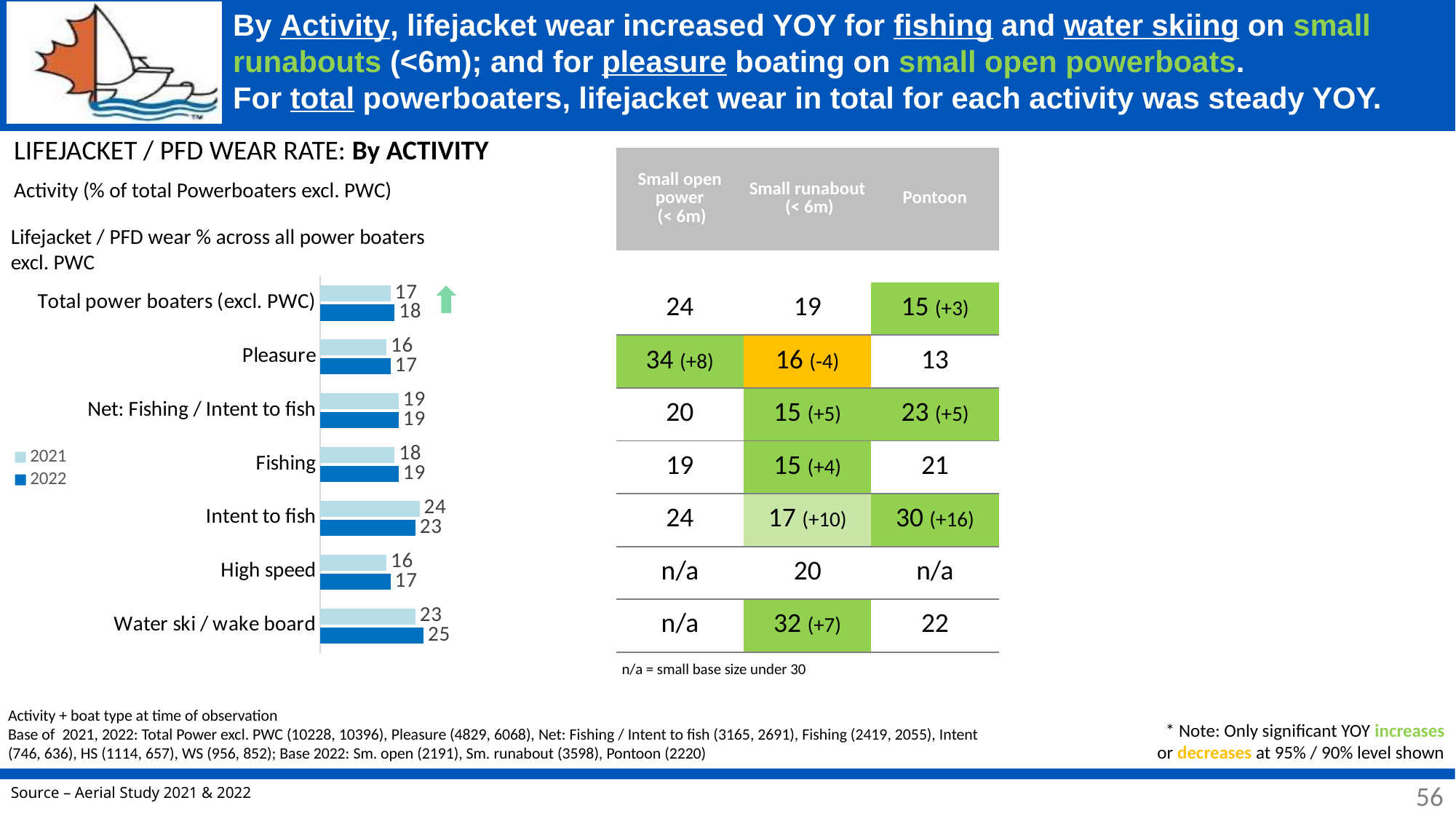
What type of chart is used to show lifejacket wear by activity? Bar chart How many activity categories are shown in the bar chart? 7 How many series does the bar chart legend list? 2 What is the difference between the 2022 and 2021 values for Water ski / wake board in the bar chart? 2 What is the 2021 value for Intent to fish in the bar chart? 24 What is the difference between the 2021 and 2022 values for Intent to fish in the bar chart? 1 What is the 2022 value for Total power boaters (excl. PWC) in the bar chart? 18 Which activity has the highest 2021 value in the bar chart? Intent to fish What is the 2022 lifejacket wear rate for Water ski / wake board in the bar chart? 25 Which years are listed in the bar chart legend? 2021 and 2022 In the bar chart, is the 2022 value for Intent to fish or for Water ski / wake board larger? Water ski / wake board Which activity has the highest 2022 value in the bar chart? Water ski / wake board